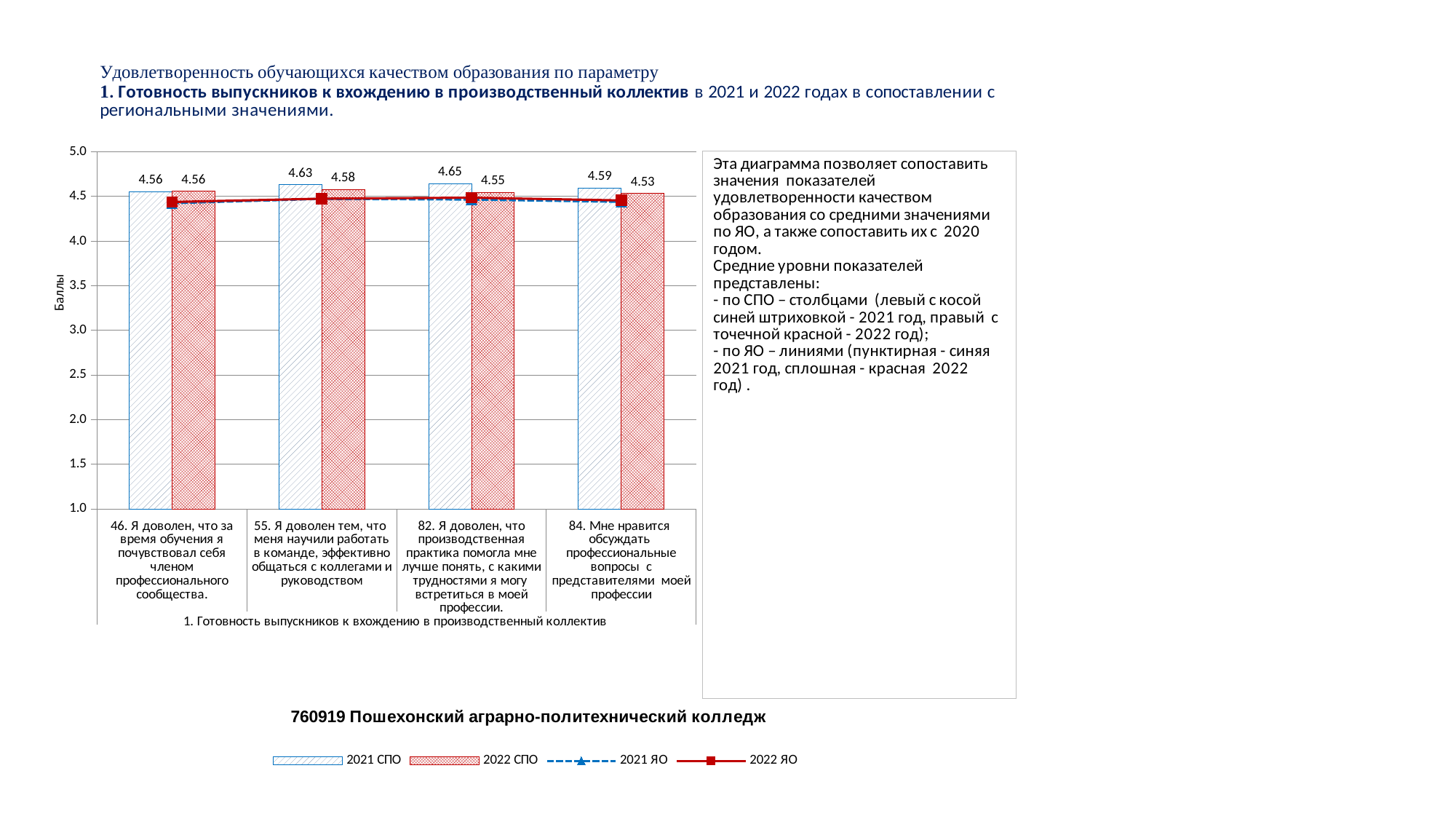
Which category has the highest 2021 СПО value? 82. Я доволен, что производственная практика помогла мне лучше понять, с какими трудностями я могу встретиться в моей профессии. What is the 2022 СПО value for category 55 ("Я доволен тем, что меня научили работать в команде...")? 4.58 What is the label of the vertical axis? Баллы For category 55, which is larger: the 2021 СПО value or the 2022 СПО value? 2021 СПО What is the 2021 СПО value for category 82 ("Я доволен, что производственная практика помогла мне лучше понять...")? 4.65 What is the 2022 СПО value for category 84 ("Мне нравится обсуждать профессиональные вопросы с представителями моей профессии")? 4.53 How many categories are shown on the x axis? 4 What is the difference between the 2021 СПО and 2022 СПО values for category 82? 0.10 Is the 2022 ЯО line value for category 46 greater or less than 4.5? less What is the 2021 СПО value for category 46 ("Я доволен, что за время обучения я почувствовал себя членом профессионального сообщества")? 4.56 Which category has the lowest 2022 СПО value? 84. Мне нравится обсуждать профессиональные вопросы с представителями моей профессии How many series does the legend list? 4